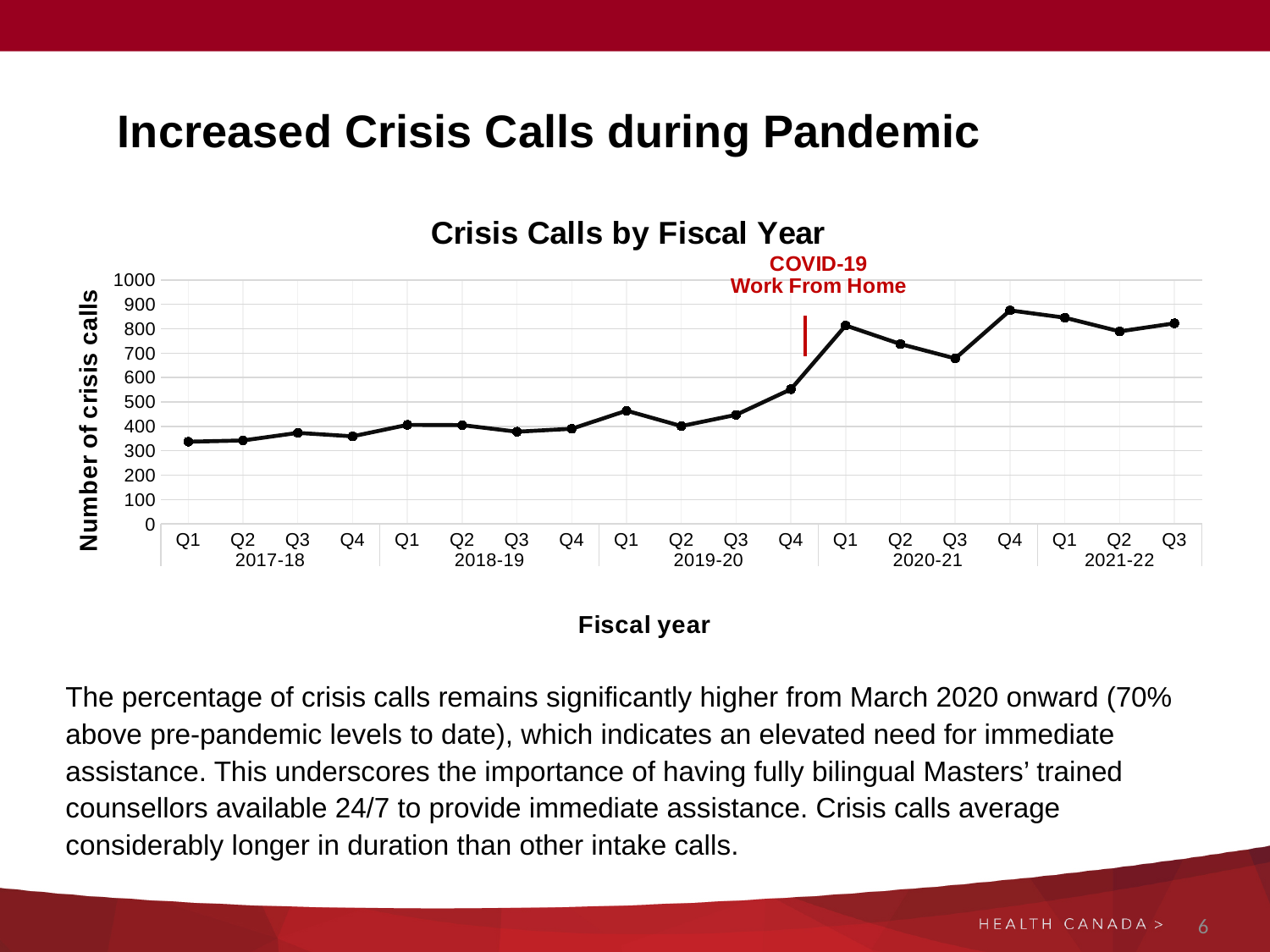
Is the value for Q1 2017-18 greater or less than 400? less Is the value for Q1 2019-20 greater or less than 400? greater Is the value for Q4 2020-21 greater or less than 800? greater Which is larger, the number of crisis calls in Q4 2019-20 or in Q1 2020-21? Q1 2020-21 What kind of chart is shown on the slide? Line chart Overall, do the number of crisis calls rise or fall from Q1 2017-18 to Q3 2021-22? Rise What is the title of the chart? Crisis Calls by Fiscal Year What event is marked by the red annotation on the chart? COVID-19 Work From Home How many quarterly data points are plotted on the line? 19 Which is larger, the number of crisis calls in Q3 2020-21 or in Q4 2020-21? Q4 2020-21